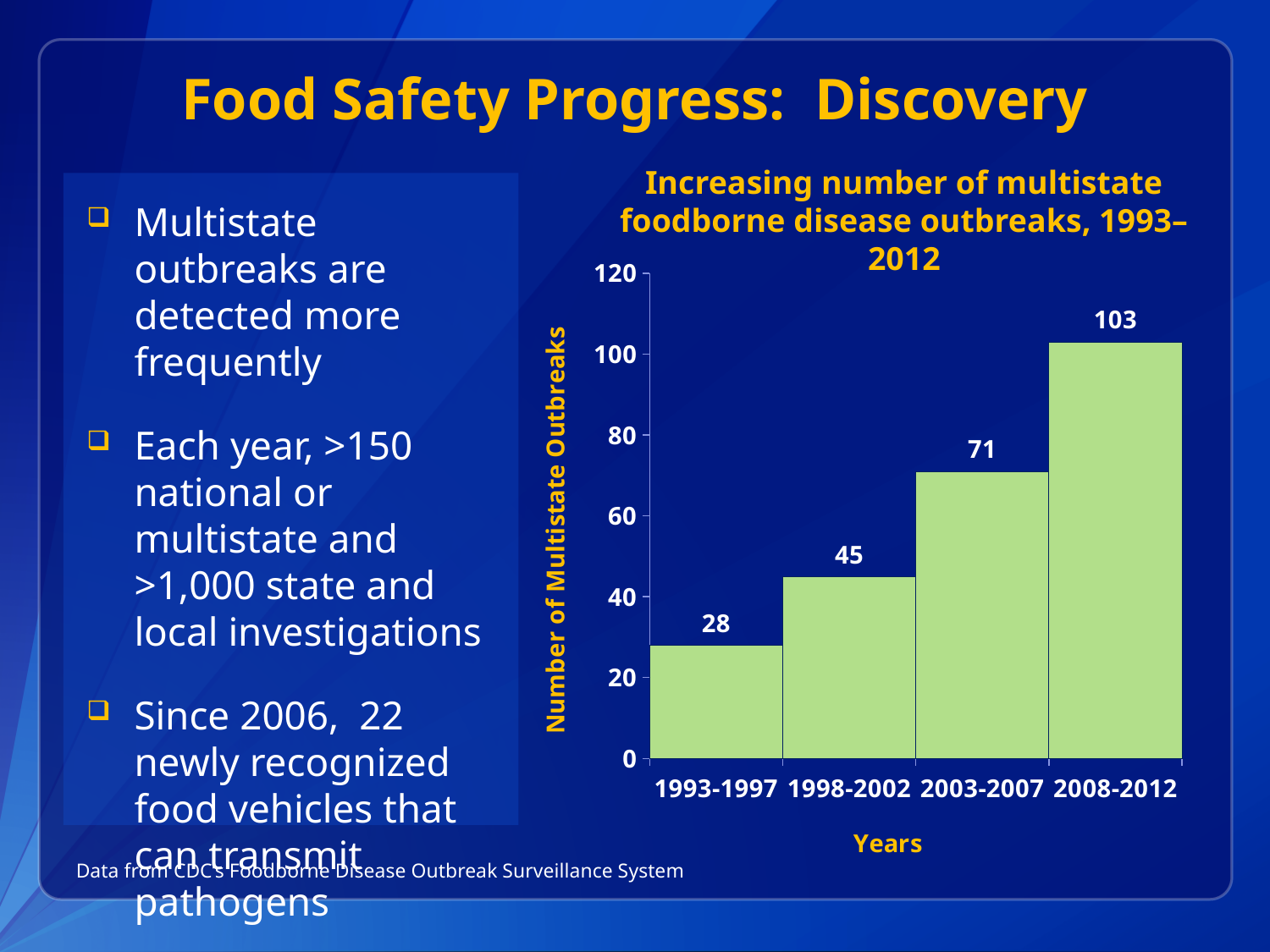
Which period has the lowest number of multistate outbreaks? 1993-1997 Is the value for 2008-2012 greater or less than 100? greater What kind of chart is shown on the slide? Bar chart What is the difference in multistate outbreaks between 2008-2012 and 2003-2007? 32 Which period has more multistate outbreaks, 1998-2002 or 2003-2007? 2003-2007 What is the number of multistate outbreaks for 2003-2007? 71 What is the number of multistate outbreaks for 2008-2012? 103 What is the number of multistate outbreaks for 1993-1997? 28 Do the values rise or fall across the periods from 1993-1997 to 2008-2012? Rise Which period has the highest number of multistate outbreaks? 2008-2012 What is the difference in multistate outbreaks between 1998-2002 and 1993-1997? 17 How many time periods are shown on the x axis? 4